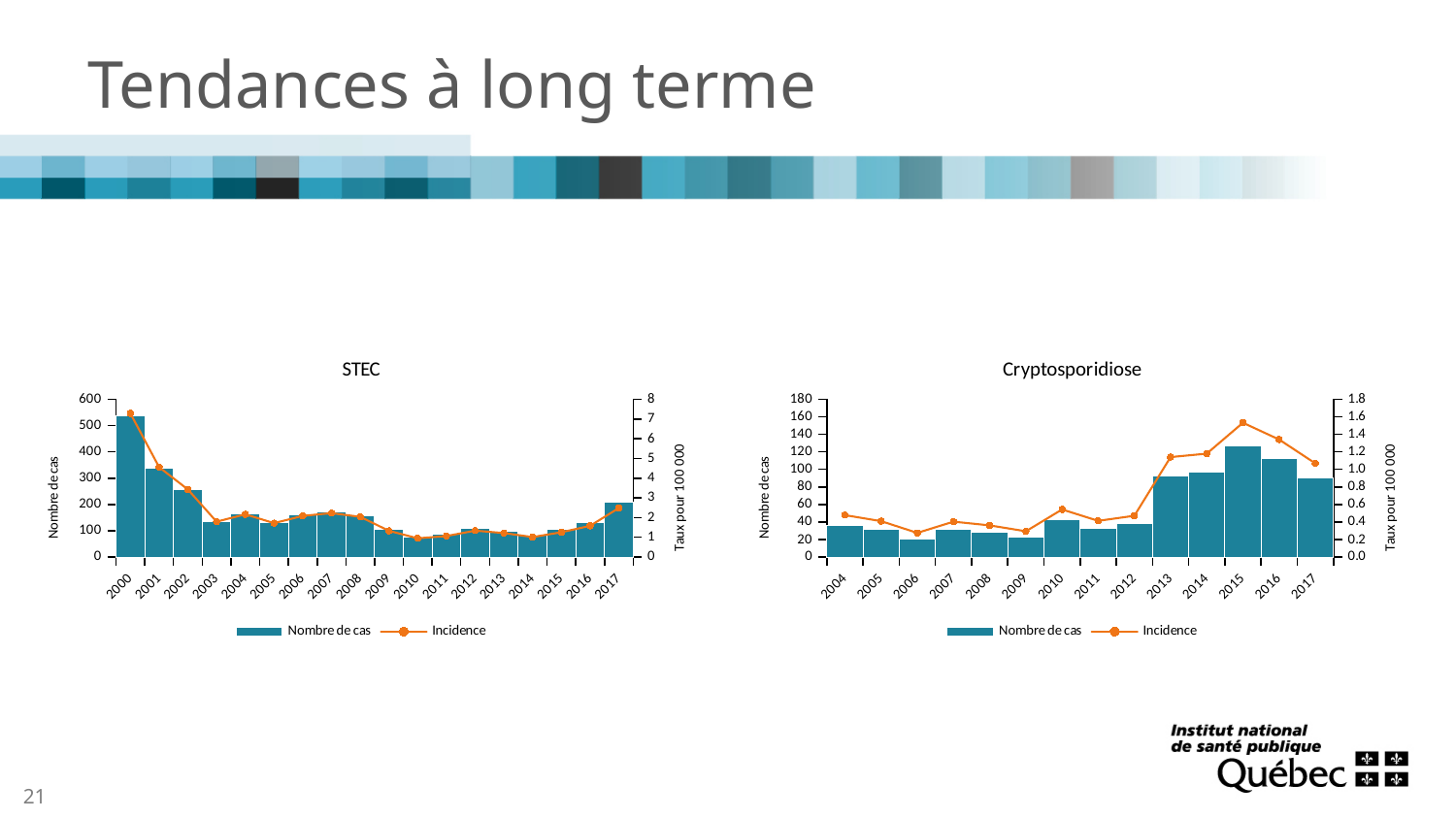
In the Cryptosporidiose chart, is the number of cases for 2015 greater or less than 100? greater How many years are shown on the x axis of the Cryptosporidiose chart? 14 In the STEC chart, which year has the highest number of cases? 2000 In the Cryptosporidiose chart, which year has more cases, 2012 or 2013? 2013 In the STEC chart, is the number of cases for 2000 greater or less than 500? greater In the Cryptosporidiose chart, which year has the highest number of cases? 2015 What is the label of the right-hand y axis on the Cryptosporidiose chart? Taux pour 100 000 How many series does the legend of the Cryptosporidiose chart list? 2 What kind of chart is the STEC chart? A combined bar and line chart In the STEC chart, does the number of cases rise or fall from 2000 to 2003? fall In the Cryptosporidiose chart, which year has the lowest number of cases? 2006 How many years are shown on the x axis of the STEC chart? 18